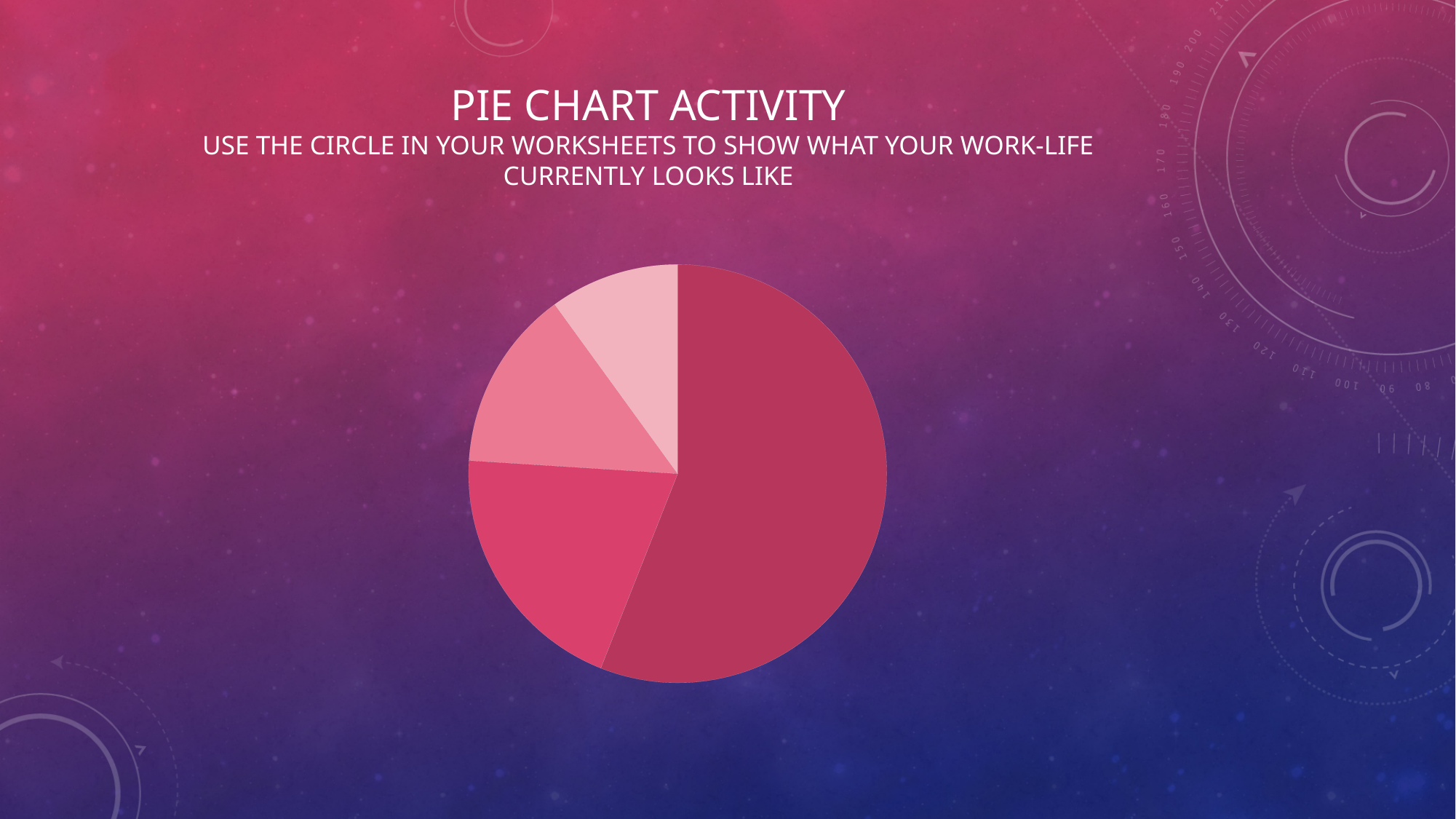
Which slice of the pie chart is the largest: the darkest red slice on the right or the lightest pink slice at the top? the darkest red slice on the right Does the largest slice of the pie chart take up more or less than half of the pie? more What is the title of the slide containing the pie chart? Pie Chart Activity Does the pie chart show any data labels or a legend? No Which slice of the pie chart is the smallest: the lightest pink slice at the top or the medium pink slice at the lower left? the lightest pink slice at the top What kind of chart is shown on the slide? pie chart How many slices does the pie chart have? 4